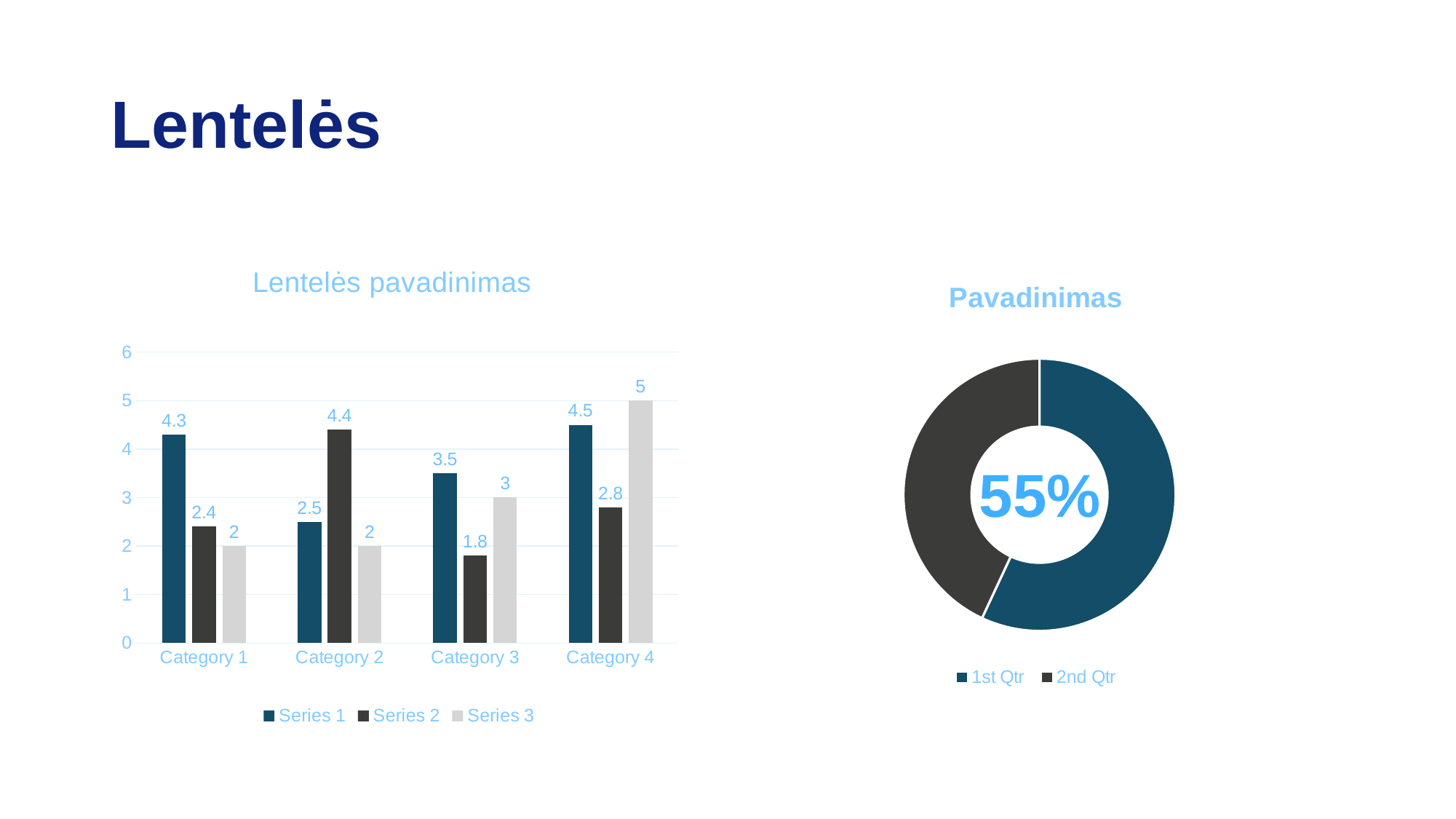
How many series does the legend of the 'Lentelės pavadinimas' chart list? 3 In the 'Lentelės pavadinimas' chart, what is the difference between Series 1 and Series 2 for Category 1? 1.9 In the 'Lentelės pavadinimas' chart, which category has the highest Series 3 value? Category 4 In the 'Lentelės pavadinimas' chart, what is the value of Series 1 for Category 4? 4.5 In the 'Lentelės pavadinimas' chart, what is the value of Series 2 for Category 3? 1.8 In the 'Lentelės pavadinimas' chart, which is larger for Category 2: Series 1 or Series 2? Series 2 How many categories are shown on the x axis of the 'Lentelės pavadinimas' chart? 4 What kind of chart is the 'Lentelės pavadinimas' chart? Bar chart How many series does the legend of the 'Pavadinimas' chart list? 2 In the 'Pavadinimas' chart, what percentage is shown in the centre of the doughnut? 55% In the 'Lentelės pavadinimas' chart, what is the value of Series 3 for Category 2? 2 In the 'Lentelės pavadinimas' chart, which category has the lowest Series 2 value? Category 3